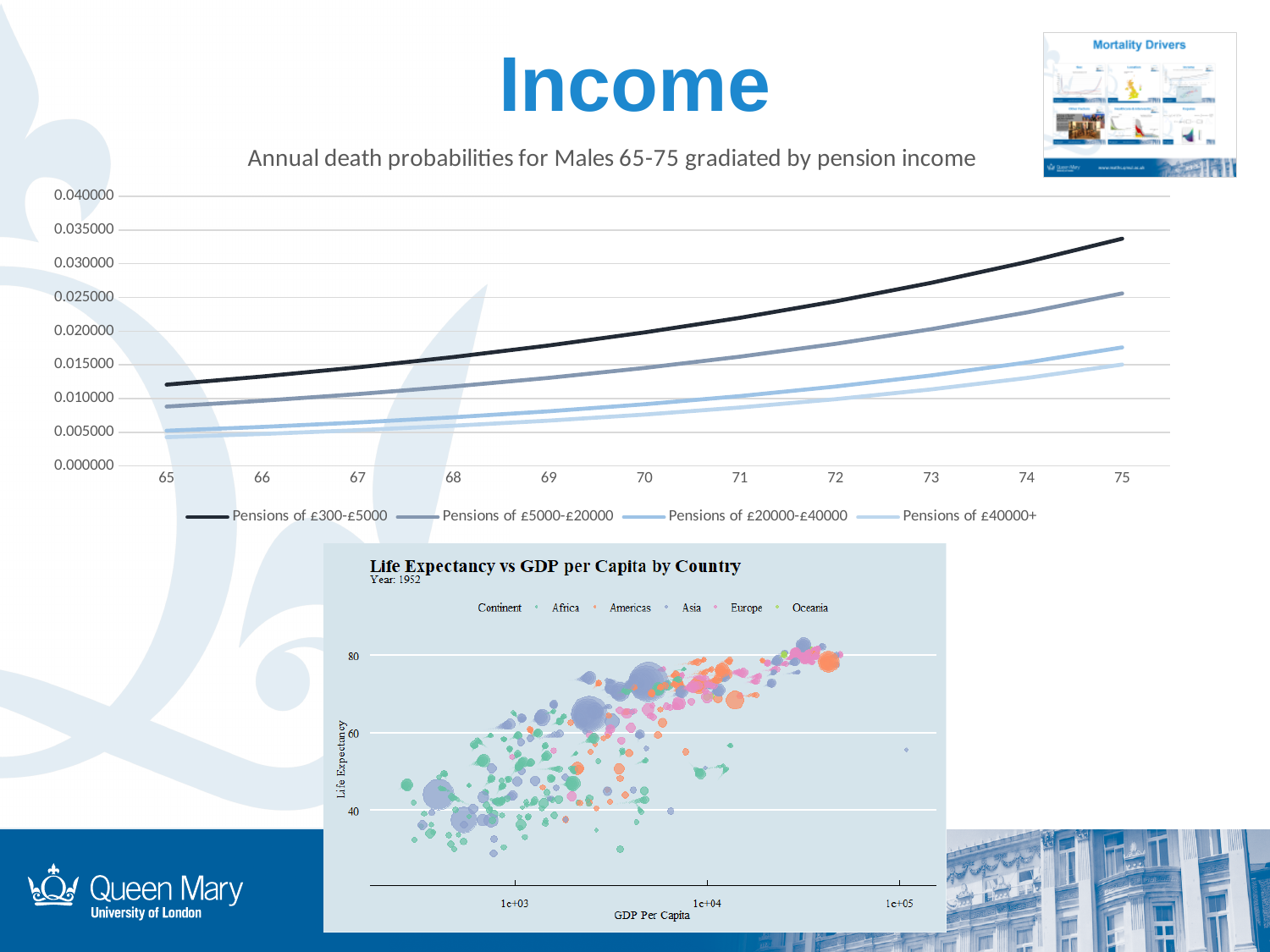
How many series does the legend of the 'Annual death probabilities' line chart list? 4 How many age points are shown on the x axis of the 'Annual death probabilities' line chart? 11 In the 'Annual death probabilities' line chart, do the death probabilities rise or fall as age increases from 65 to 75? Rise How many continents does the legend of the 'Life Expectancy vs GDP per Capita by Country' chart list? 5 In the 'Annual death probabilities' line chart, is the value for Pensions of £300-£5000 at age 65 greater or less than 0.010000? greater In the 'Annual death probabilities' line chart, is the value for Pensions of £20000-£40000 at age 75 greater or less than 0.015000? greater What kind of chart is the 'Life Expectancy vs GDP per Capita by Country' chart at the bottom of the slide? Scatter (bubble) chart In the 'Annual death probabilities' line chart, at age 72, which is larger: the value for Pensions of £5000-£20000 or the value for Pensions of £40000+? Pensions of £5000-£20000 In the 'Annual death probabilities' line chart, is the value for Pensions of £300-£5000 at age 75 greater or less than 0.030000? greater In the 'Annual death probabilities' line chart, which pension income group has the highest death probability at age 75? Pensions of £300-£5000 In the 'Annual death probabilities' line chart, which pension income group has the lowest death probability at age 65? Pensions of £40000+ What kind of chart is the 'Annual death probabilities for Males 65-75 gradiated by pension income' chart? Line chart